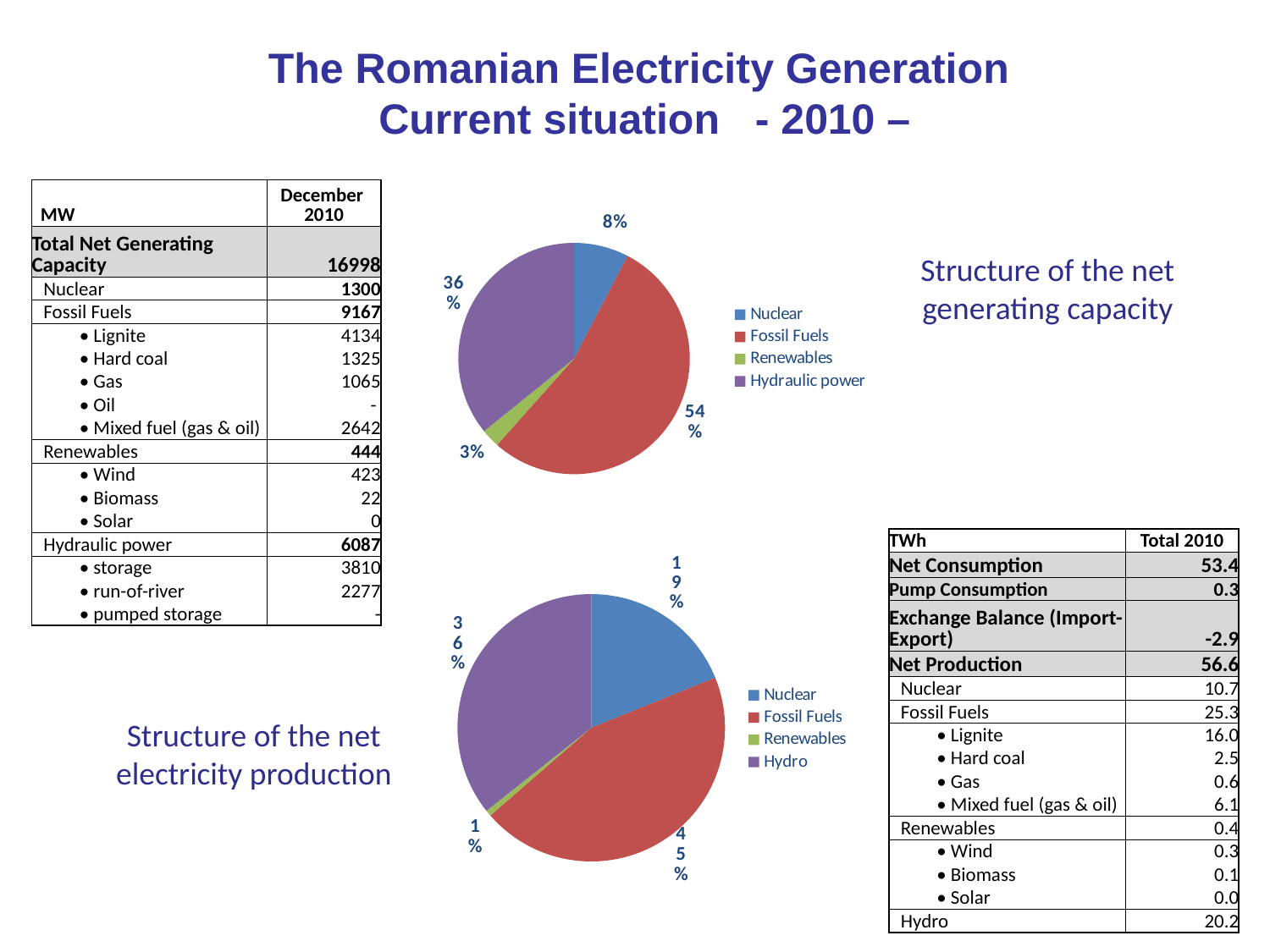
In the top pie chart (Structure of the net generating capacity), what share does Nuclear have? 8% In the top pie chart (Structure of the net generating capacity), what share does Hydraulic power have? 36% In the bottom pie chart (Structure of the net electricity production), what share does Nuclear have? 19% In the bottom pie chart (Structure of the net electricity production), which is larger, Nuclear or Hydro? Hydro In the top pie chart (Structure of the net generating capacity), which category has the smallest share? Renewables In the bottom pie chart (Structure of the net electricity production), what is the difference in percentage points between Fossil Fuels and Hydro? 9 What type of chart is used for the Structure of the net electricity production? Pie chart In the top pie chart (Structure of the net generating capacity), which category has the largest share? Fossil Fuels How many categories does the legend of the top pie chart (Structure of the net generating capacity) list? 4